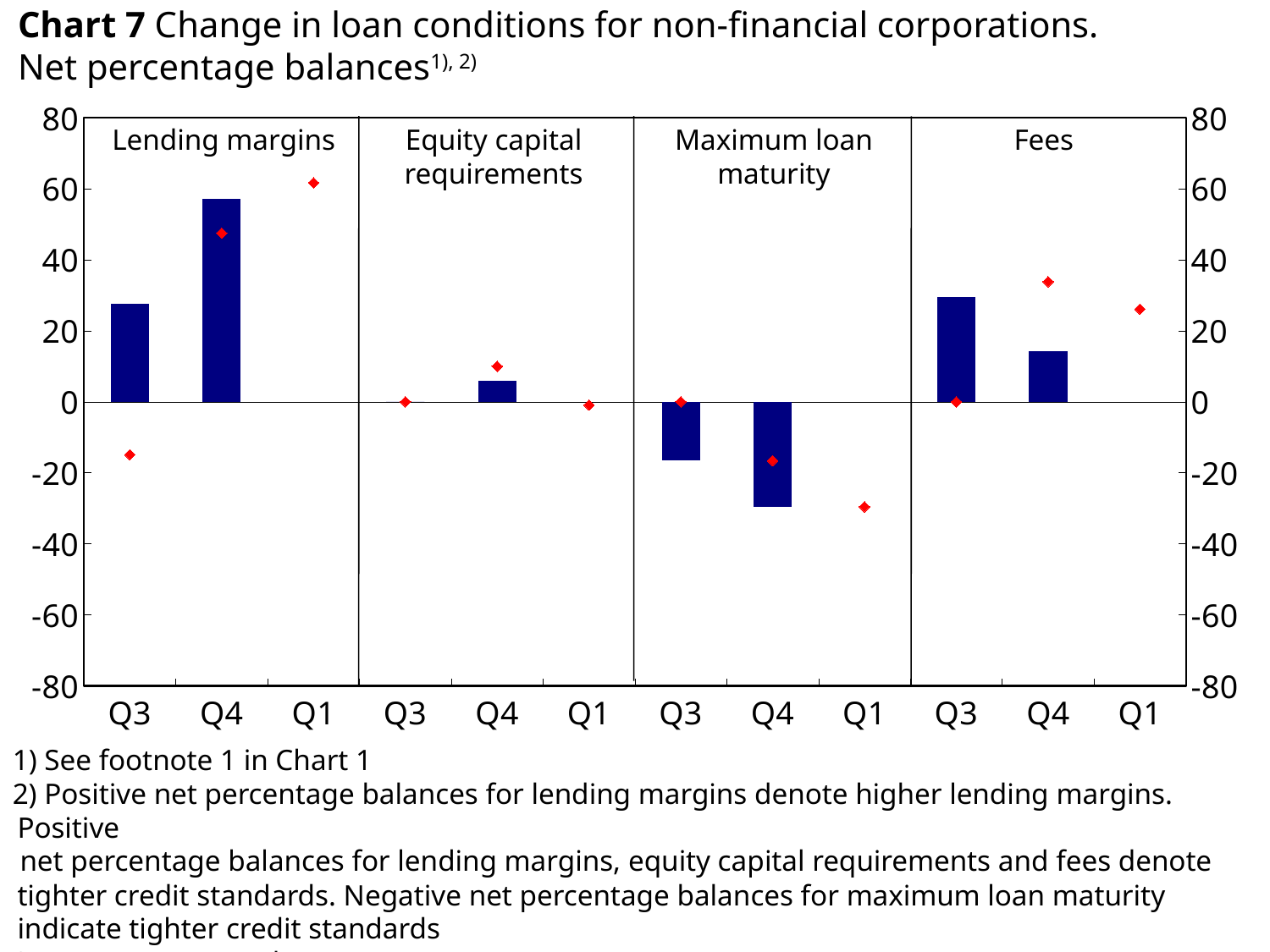
In the Equity capital requirements panel, is the Q4 bar greater or less than 20? less What kind of chart is Chart 7? combination bar and line chart (bars with point markers) In the Lending margins panel, is the Q4 bar greater or less than 40? greater In the Lending margins panel, which bar is taller, Q3 or Q4? Q4 In the Lending margins panel, is the Q3 bar greater or less than 20? greater In the Maximum loan maturity panel, do the bars rise or fall from Q3 to Q4? fall In the Fees panel, which bar is taller, Q3 or Q4? Q3 How many loan-condition panels does Chart 7 contain? 4 Which panel contains the tallest bar in the chart? Lending margins How many quarters are shown on the x axis of each panel? 3 Which panel is the only one with negative bars? Maximum loan maturity